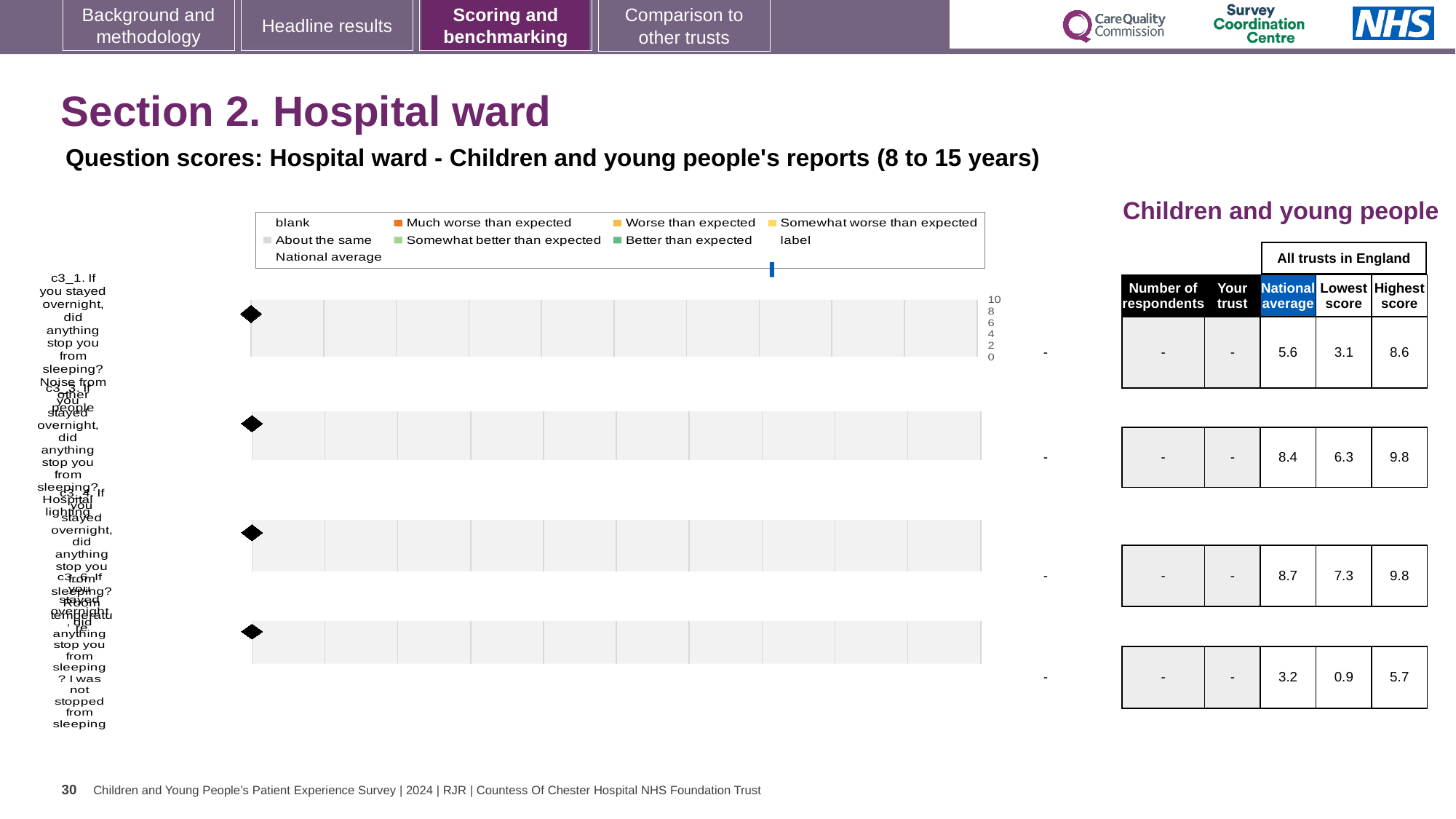
In the table beside the charts, what is the National average for the top row (c3_1, noise from other people)? 5.6 For the top row (c3_1), what is the difference between the Highest score and the Lowest score? 5.5 Which legend entry is shown with an orange marker? Much worse than expected Is the National average higher for the top row (c3_1) or the second row (c3_3)? the second row (c3_3) In the table beside the charts, what is the Highest score for the second row (c3_3)? 9.8 What kind of chart is used for the question scores on this slide? bar chart In the table beside the charts, what is the Lowest score for the bottom row (c3_6)? 0.9 Which row has the highest National average in the table beside the charts? the third row (c3_4), 8.7 What is the maximum value shown on the score axis of the charts? 10 How many question rows (charts) are plotted on the slide? 4 Which row has the lowest National average in the table beside the charts? the bottom row (c3_6), 3.2 What value is shown in the 'Your trust' column for the top row? -